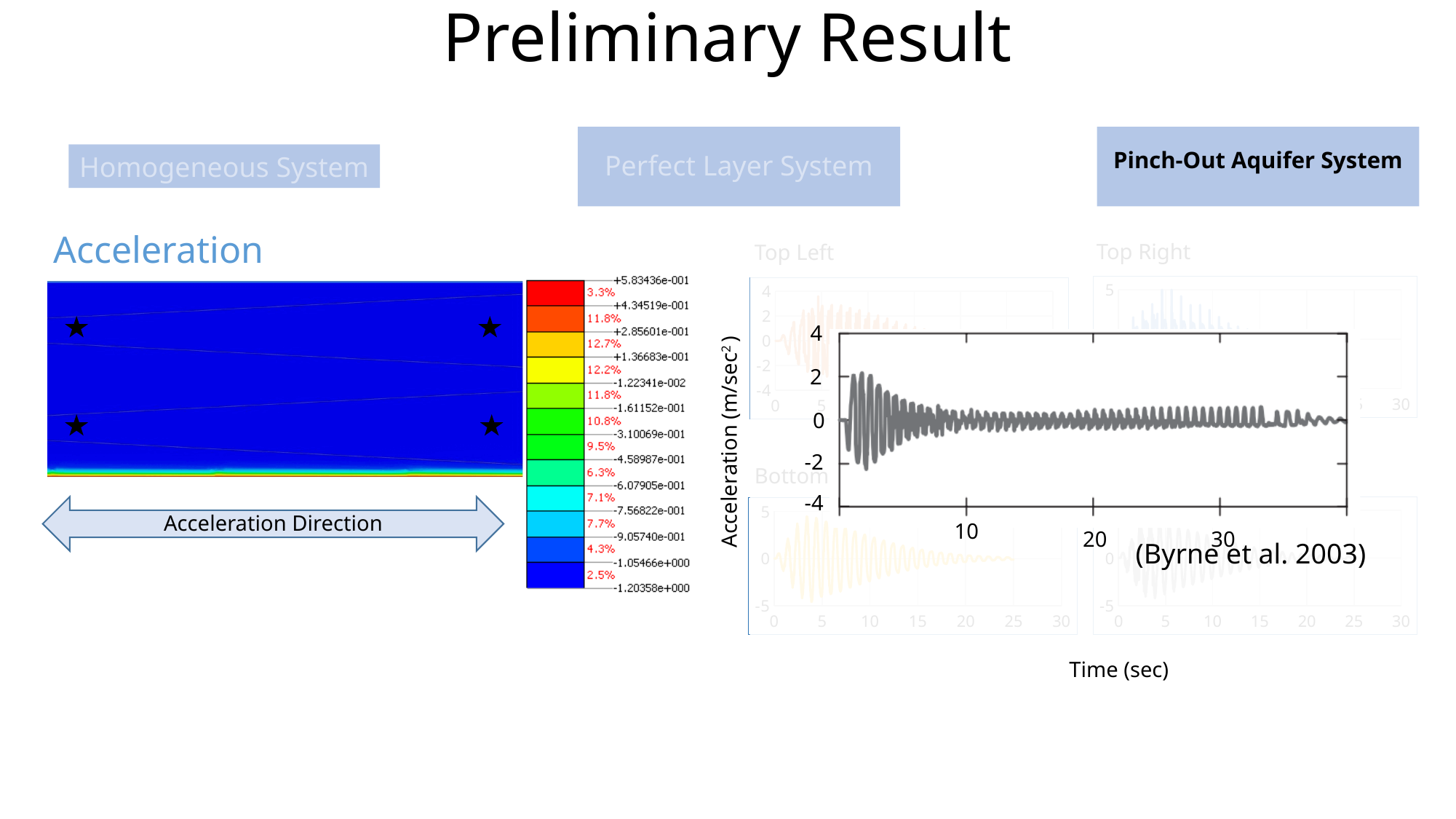
In the large line chart on the right, does the amplitude of the oscillation increase or decrease as time goes on? decrease In the large line chart on the right, is the lowest acceleration value reached greater or less than -4? greater What kind of chart is the large chart on the right side of the slide? line chart In the colour legend next to the contour plot on the left, what is the highest value listed? +5.83436e-001 In the colour legend next to the contour plot on the left, what is the smallest percentage shown? 2.5% In the colour legend next to the contour plot on the left, what is the largest percentage shown? 12.7% In the large line chart on the right, is the highest acceleration value reached greater or less than 4? less In the large line chart on the right, what is the x-axis label? Time (sec) How many x-axis tick labels are shown on the large line chart on the right? 3 In the large line chart on the right, what is the y-axis label? Acceleration (m/sec²) In the colour legend next to the contour plot on the left, what is the lowest value listed? -1.20358e+000 In the large line chart on the right, is the acceleration amplitude at 20 seconds greater or less than 2? less